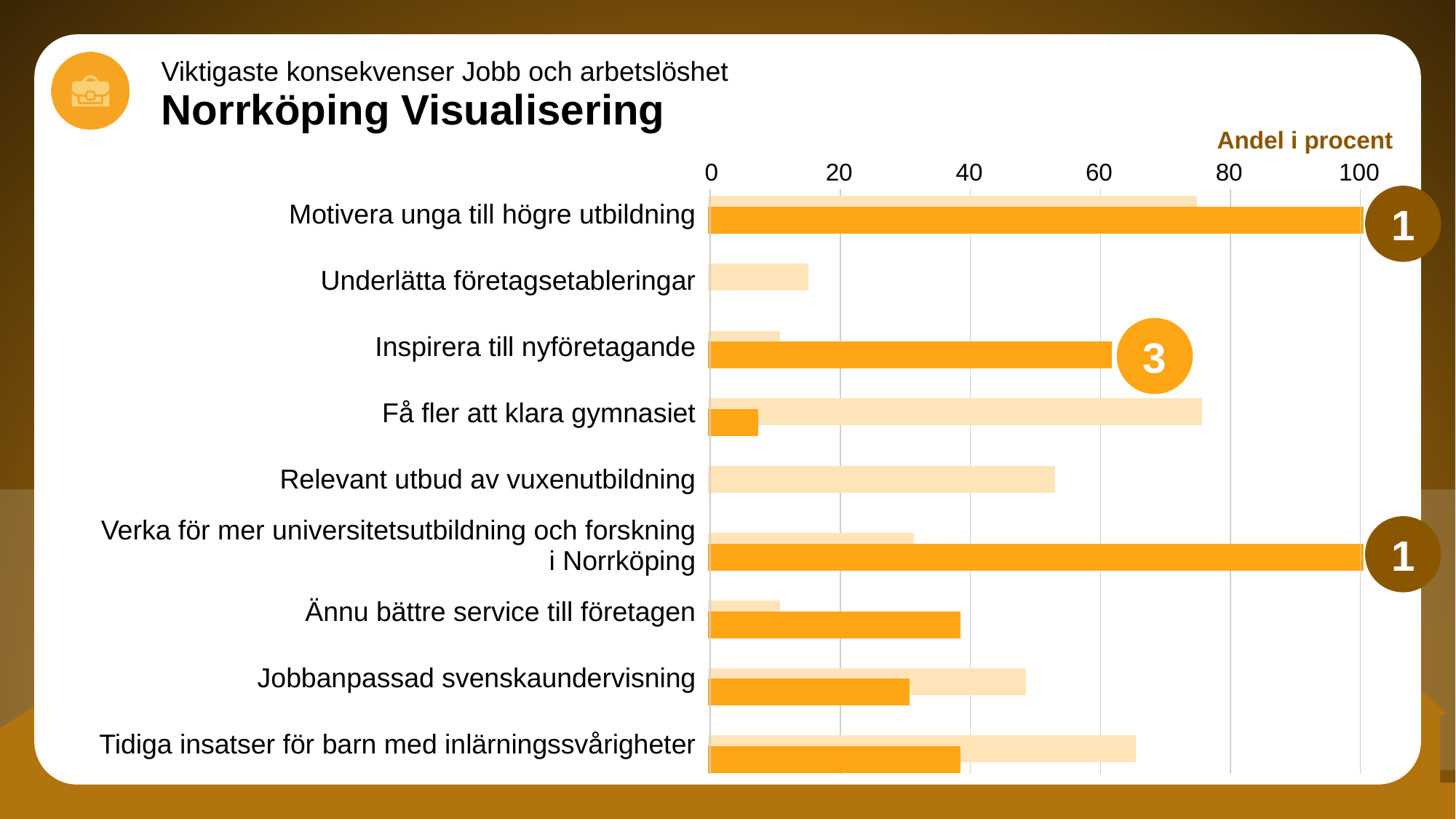
Which has the longer light orange bar: 'Relevant utbud av vuxenutbildning' or 'Underlätta företagsetableringar'? Relevant utbud av vuxenutbildning Is the dark orange bar for 'Ännu bättre service till företagen' greater or less than 20? greater Is the light orange bar for 'Underlätta företagsetableringar' greater or less than 20? less What is the highest value shown on the chart's horizontal axis? 100 Which has the longer dark orange bar: 'Inspirera till nyföretagande' or 'Jobbanpassad svenskaundervisning'? Inspirera till nyföretagande Is the light orange bar for 'Få fler att klara gymnasiet' greater or less than 60? greater What is the label shown above the chart's horizontal axis? Andel i procent How many categories are listed on the chart's vertical axis? 9 What kind of chart is shown on the slide? bar chart